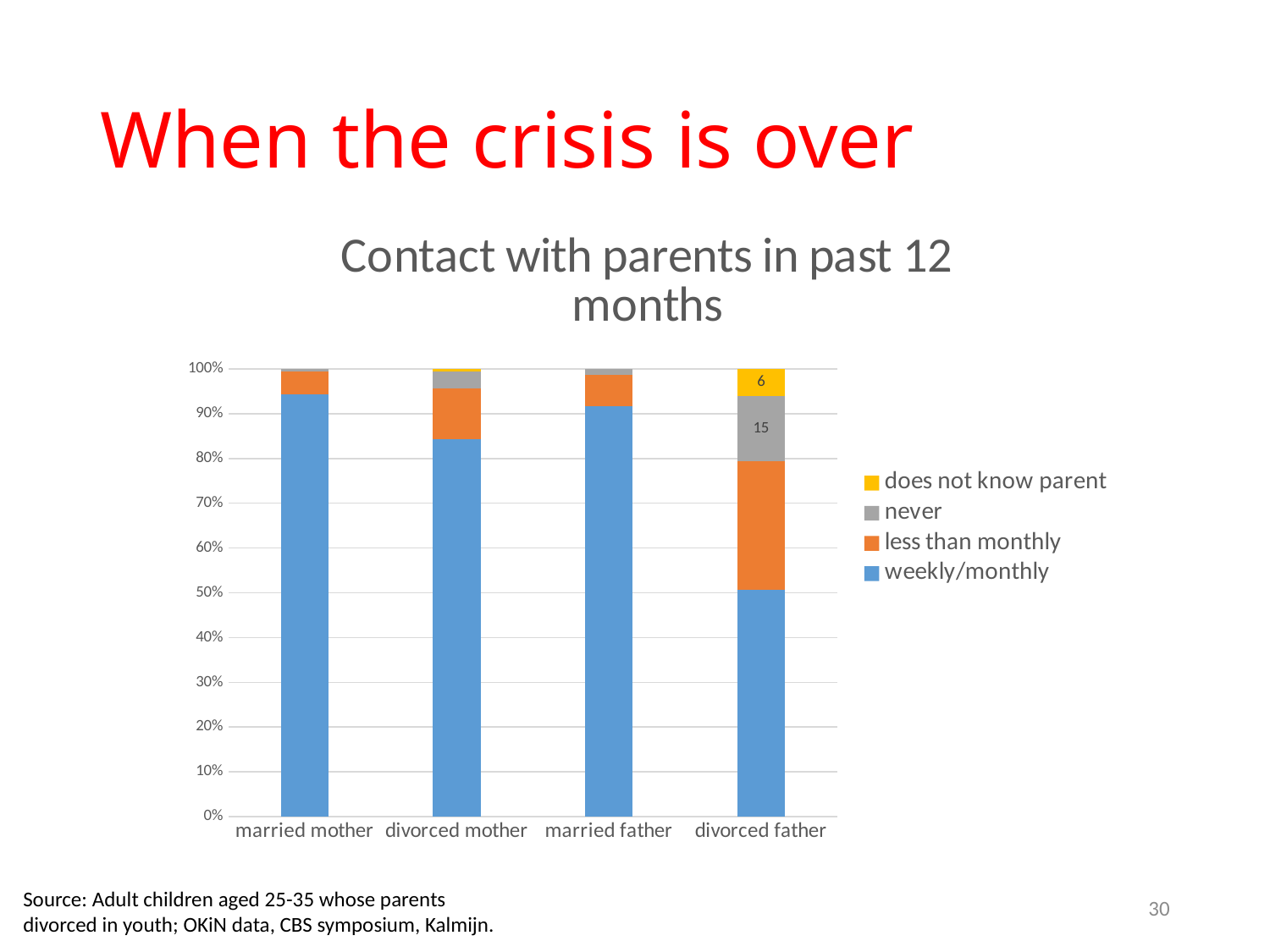
What kind of chart is shown on the slide? stacked bar chart How many categories are shown on the x axis of the chart? 4 What is the labelled value of the 'does not know parent' segment for divorced father? 6 Which colour represents the 'weekly/monthly' series in the legend? blue Which has a larger 'weekly/monthly' share, divorced mother or divorced father? divorced mother Which category has the largest 'less than monthly' segment? divorced father What is the labelled value of the 'never' segment for divorced father? 15 Which category has the smallest 'weekly/monthly' share? divorced father Is the 'weekly/monthly' share for divorced father greater or less than 60%? less How many series does the legend list? 4 Is the 'weekly/monthly' share for married mother greater or less than 90%? greater What is the title of the chart? Contact with parents in past 12 months